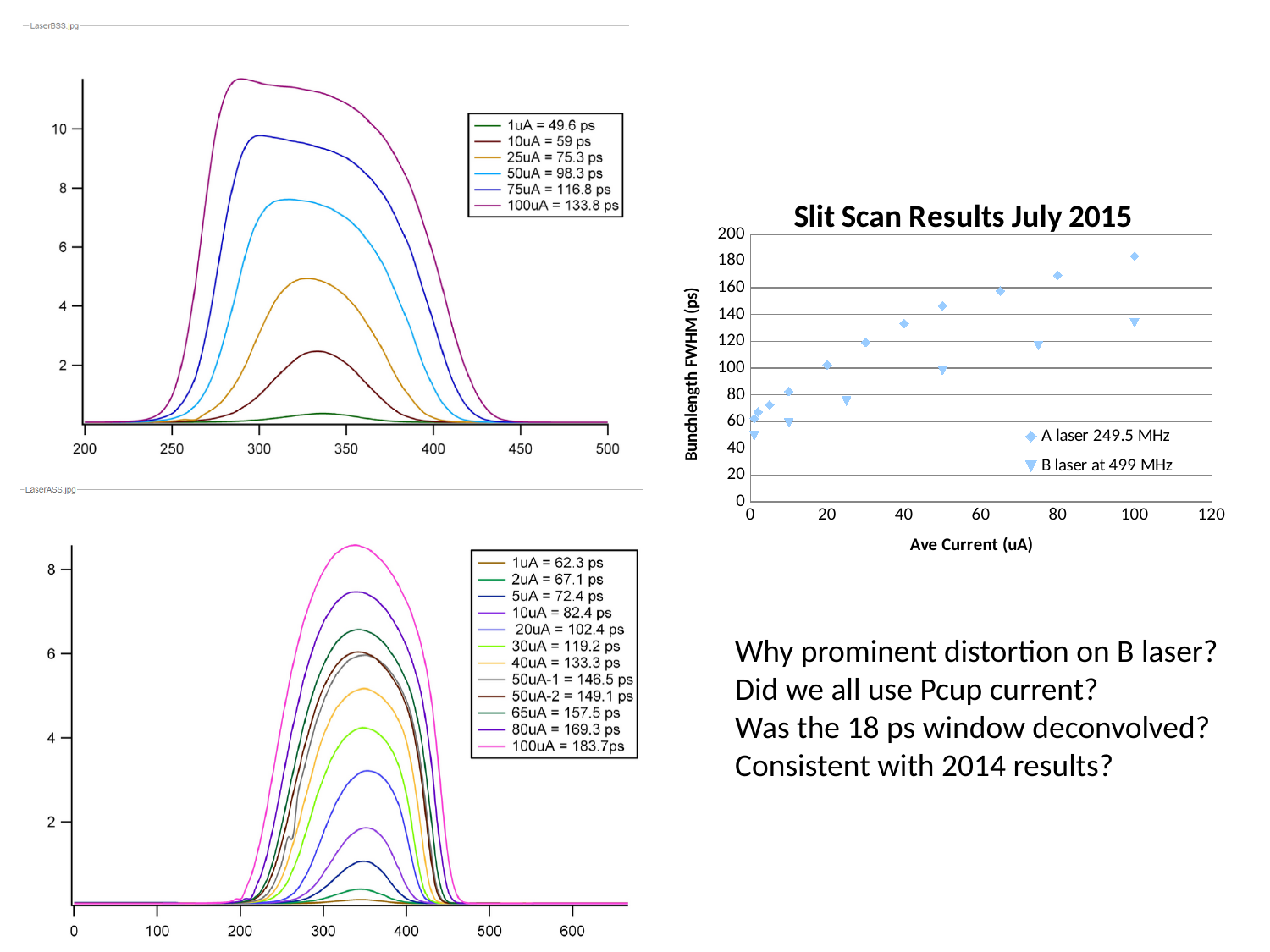
In the 'Slit Scan Results July 2015' chart, is the A laser 249.5 MHz value at 100 uA greater or less than 160? greater How many series does the legend of the 'Slit Scan Results July 2015' chart list? 2 How many series does the legend of the bottom-left chart (LaserASS.jpg) list? 12 In the bottom-left chart (LaserASS.jpg), what bunch length does the legend give for 100uA? 183.7 ps What is the x-axis label of the 'Slit Scan Results July 2015' chart? Ave Current (uA) What kind of chart is the 'Slit Scan Results July 2015' chart? scatter chart In the bottom-left chart (LaserASS.jpg), what is the difference between the legend values for 50uA-2 and 50uA-1? 2.6 ps In the top-left chart (LaserBSS.jpg), what bunch length does the legend give for 100uA? 133.8 ps How many series does the legend of the top-left chart (LaserBSS.jpg) list? 6 In the 'Slit Scan Results July 2015' chart, does the A laser 249.5 MHz series rise or fall as average current increases? rise In the 'Slit Scan Results July 2015' chart, which series has the higher value at 100 uA, A laser 249.5 MHz or B laser at 499 MHz? A laser 249.5 MHz In the 'Slit Scan Results July 2015' chart, is the B laser at 499 MHz value at 100 uA greater or less than 160? less